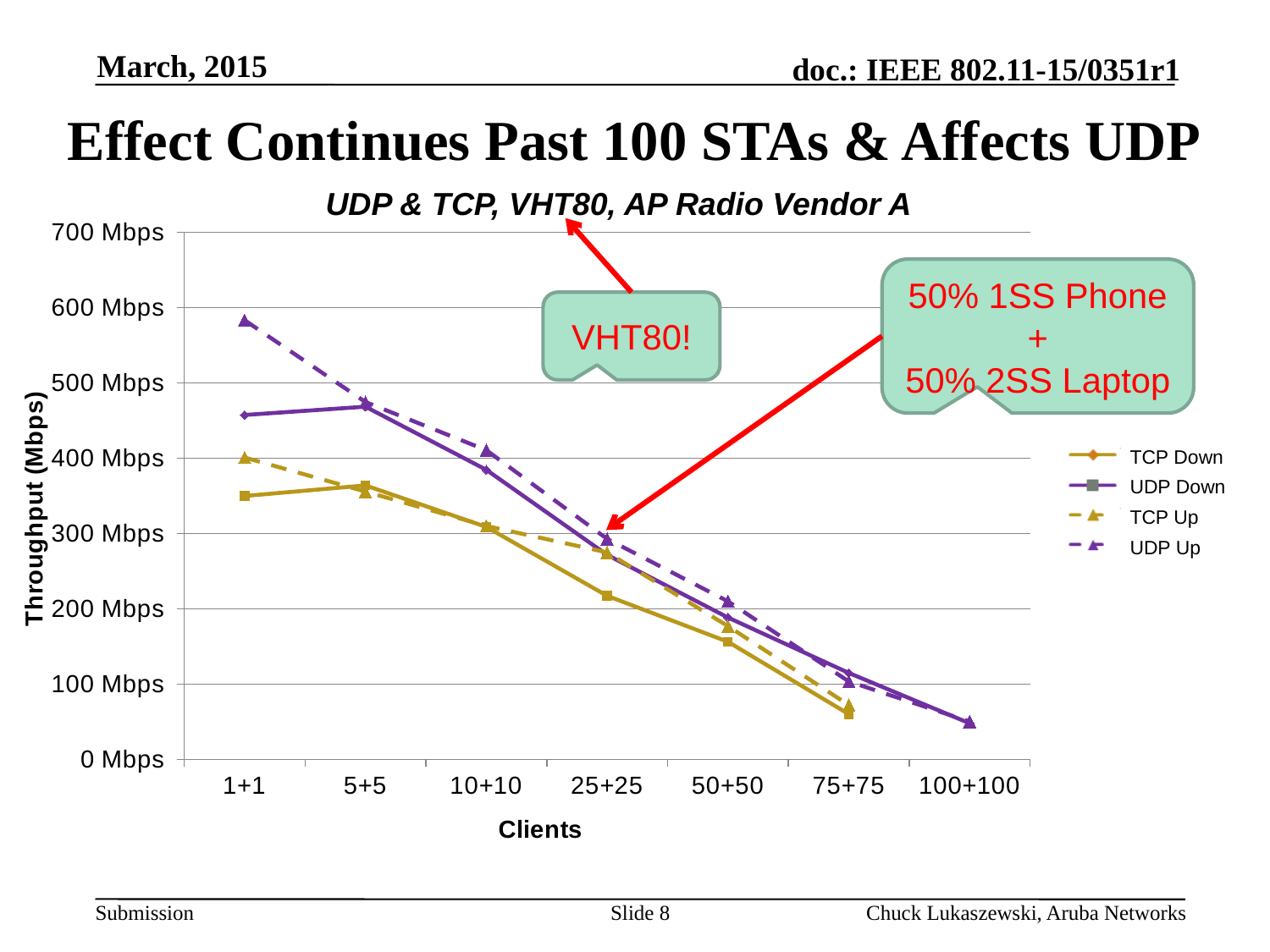
Which series has the lowest throughput at 1+1 clients? TCP Down Which series has the highest throughput at 1+1 clients? UDP Up Do the throughput values rise or fall as the number of clients increases along the x axis? fall Is the UDP Up value at 100+100 clients greater or less than 100 Mbps? less What is the label of the y axis? Throughput (Mbps) At 25+25 clients, which is larger: UDP Up or TCP Down? UDP Up How many series does the legend list? 4 What is the title of the chart? UDP & TCP, VHT80, AP Radio Vendor A Is the UDP Up value at 1+1 clients greater or less than 500 Mbps? greater How many client categories are shown on the x axis? 7 What kind of chart is shown on the slide? line chart Is the UDP Down value at 1+1 clients greater or less than 500 Mbps? less